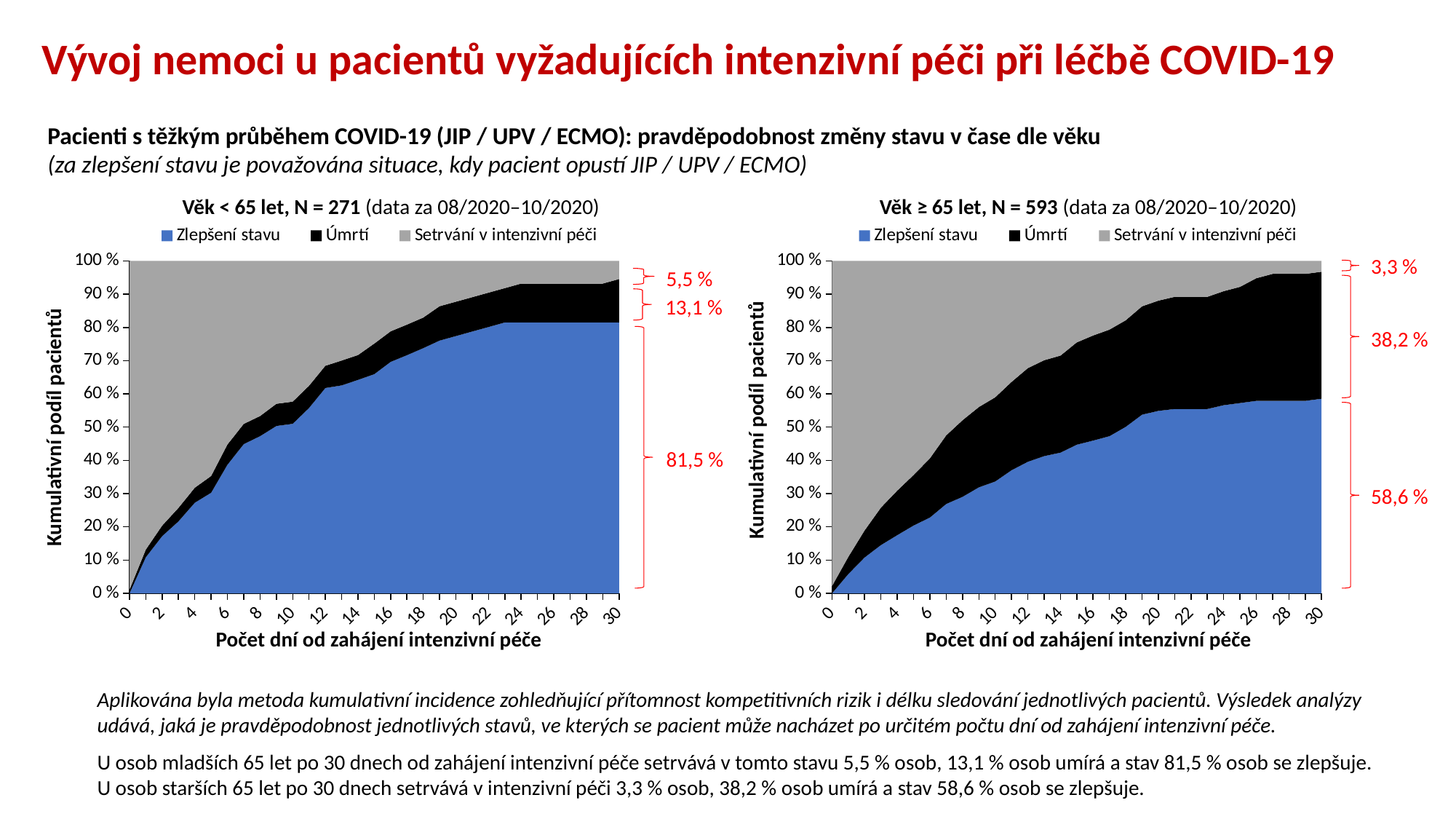
Which chart shows the higher share of deaths ("Úmrtí") at day 30, "Věk < 65 let" or "Věk ≥ 65 let"? Věk ≥ 65 let In the "Věk ≥ 65 let" chart, what share of patients is in the "Úmrtí" state at day 30? 38,2 % In the "Věk < 65 let" chart, which state has the smallest share at day 30? Setrvání v intenzivní péči What is the difference between the "Zlepšení stavu" share at day 30 in the "Věk < 65 let" chart and in the "Věk ≥ 65 let" chart? 22,9 % In the "Věk < 65 let" chart, what share of patients remains in intensive care ("Setrvání v intenzivní péči") at day 30? 5,5 % In the "Věk < 65 let" chart, does the "Zlepšení stavu" share rise or fall as the number of days increases? Rises What kind of chart is the "Věk < 65 let" chart? Stacked area chart In the "Věk ≥ 65 let" chart, what is the difference between the "Úmrtí" share and the "Setrvání v intenzivní péči" share at day 30? 34,9 % How many series does the legend of the "Věk ≥ 65 let" chart list? 3 In the "Věk < 65 let" chart, what share of patients is in the "Zlepšení stavu" state at day 30? 81,5 % In the "Věk ≥ 65 let" chart, is the "Zlepšení stavu" share at day 10 greater or less than 40 %? less In the "Věk ≥ 65 let" chart, what share of patients is in the "Zlepšení stavu" state at day 30? 58,6 %